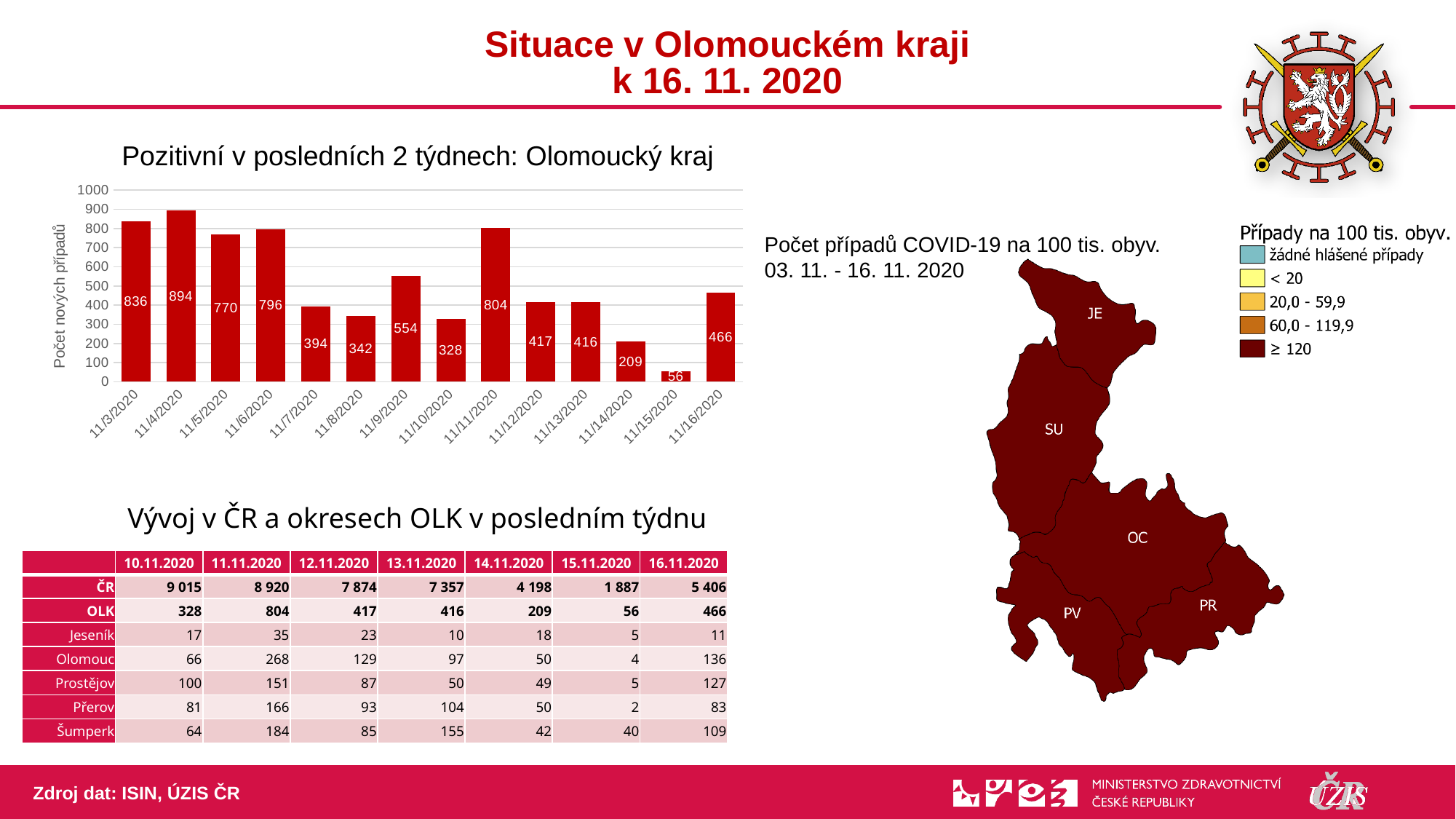
In the bar chart "Pozitivní v posledních 2 týdnech: Olomoucký kraj", what is the value for 11/9/2020? 554 What type of chart is shown under the title "Pozitivní v posledních 2 týdnech: Olomoucký kraj"? bar chart In the bar chart "Pozitivní v posledních 2 týdnech: Olomoucký kraj", do the values rise or fall from 11/11/2020 to 11/15/2020? fall In the bar chart "Pozitivní v posledních 2 týdnech: Olomoucký kraj", which date has the lowest value? 11/15/2020 How many dates (bars) are shown in the bar chart "Pozitivní v posledních 2 týdnech: Olomoucký kraj"? 14 In the bar chart "Pozitivní v posledních 2 týdnech: Olomoucký kraj", which is larger, the value for 11/9/2020 or for 11/12/2020? 11/9/2020 What is the label of the vertical axis in the bar chart "Pozitivní v posledních 2 týdnech: Olomoucký kraj"? Počet nových případů In the bar chart "Pozitivní v posledních 2 týdnech: Olomoucký kraj", what is the value for 11/4/2020? 894 In the bar chart "Pozitivní v posledních 2 týdnech: Olomoucký kraj", which date has the highest value? 11/4/2020 In the bar chart "Pozitivní v posledních 2 týdnech: Olomoucký kraj", what is the value for 11/15/2020? 56 In the bar chart "Pozitivní v posledních 2 týdnech: Olomoucký kraj", what is the difference between the values for 11/11/2020 and 11/10/2020? 476 In the bar chart "Pozitivní v posledních 2 týdnech: Olomoucký kraj", what is the difference between the values for 11/3/2020 and 11/5/2020? 66